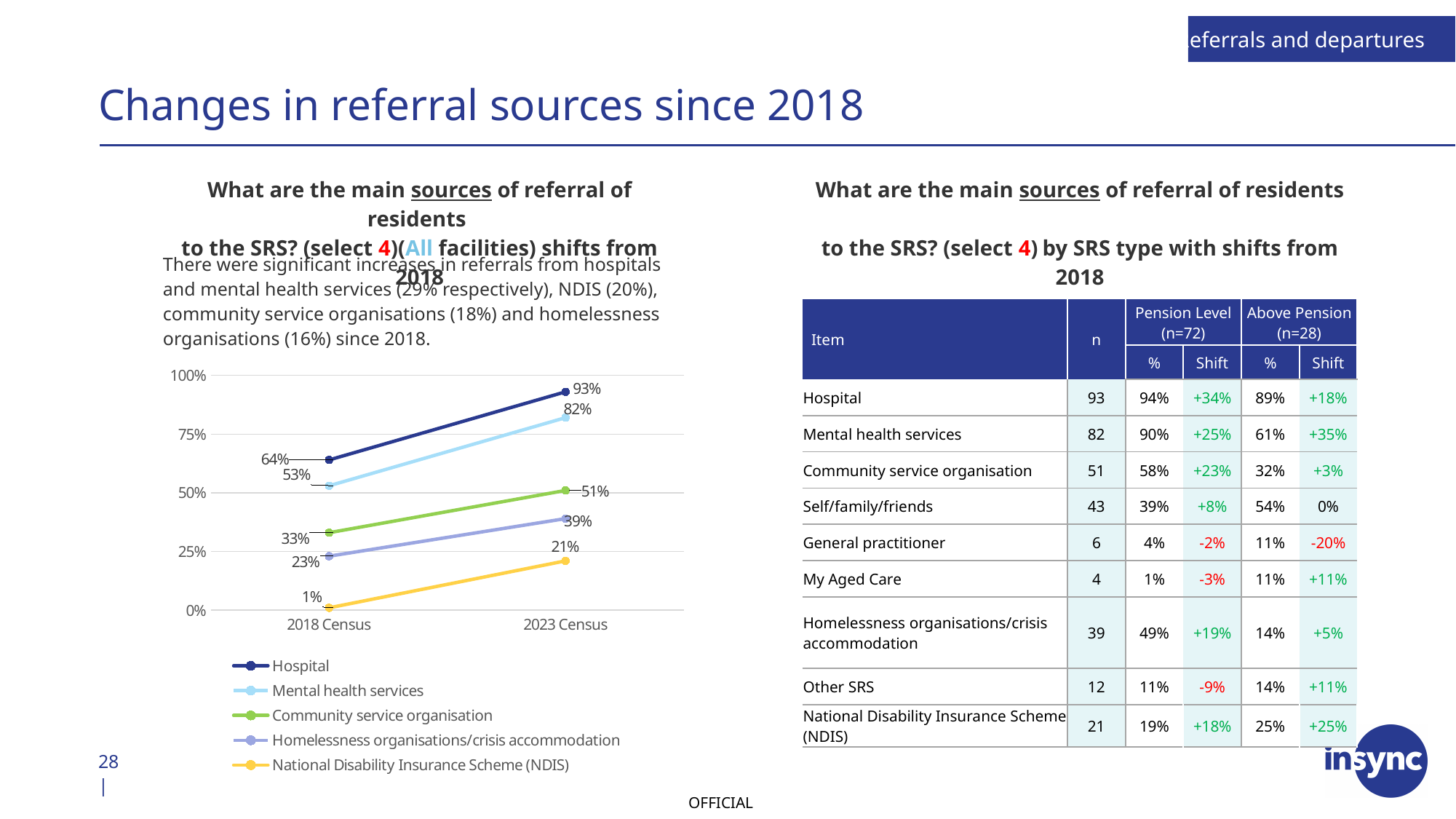
What is the value for Hospital at the 2023 Census? 93% What is the difference between the Hospital values at the 2023 Census and the 2018 Census? 29% What is the value for National Disability Insurance Scheme (NDIS) at the 2018 Census? 1% How many series does the chart's legend list? 5 How many census points are shown on the x axis of the chart? 2 Which series has the highest value at the 2023 Census? Hospital Which is larger at the 2023 Census: Community service organisation or Homelessness organisations/crisis accommodation? Community service organisation What kind of chart is shown on the slide? line chart Do the values for Mental health services rise or fall from the 2018 Census to the 2023 Census? rise Which series has the lowest value at the 2018 Census? National Disability Insurance Scheme (NDIS) What is the value for Mental health services at the 2018 Census? 53% What colour is the line for Hospital in the chart? dark blue